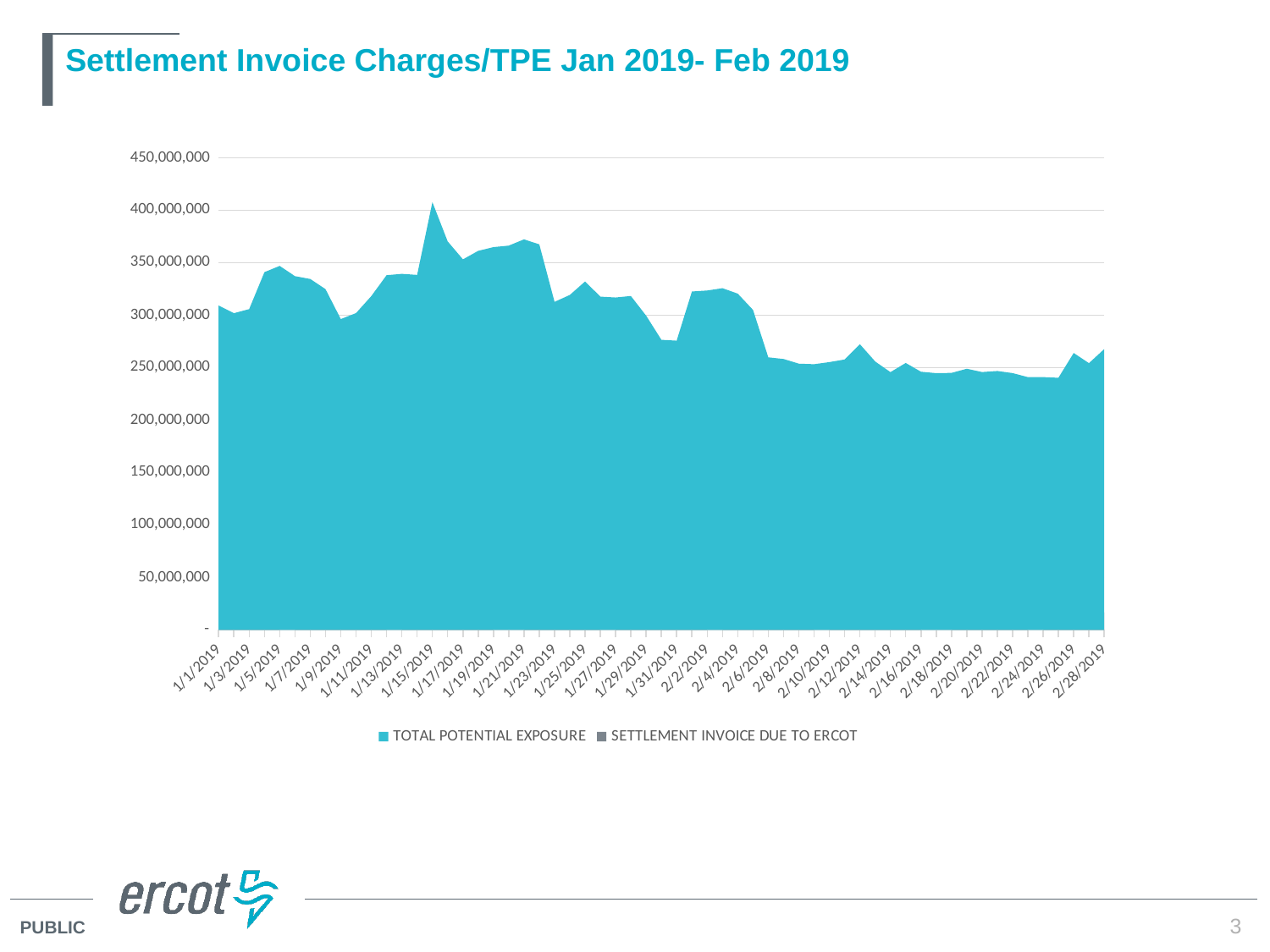
On which date does Total Potential Exposure reach its highest value? 1/15/2019 Overall, does Total Potential Exposure rise or fall from January 2019 to February 2019? fall What kind of chart is shown on the slide? Area chart What are the two series named in the legend? TOTAL POTENTIAL EXPOSURE and SETTLEMENT INVOICE DUE TO ERCOT Is the Total Potential Exposure on 1/15/2019 greater or less than 350,000,000? greater Which date has the larger Total Potential Exposure, 1/5/2019 or 2/14/2019? 1/5/2019 How many series does the legend list? 2 Is the Total Potential Exposure on 1/21/2019 greater or less than 350,000,000? greater Is the Total Potential Exposure on 2/8/2019 greater or less than 300,000,000? less How many date labels are shown on the x axis? 30 What is the title of the slide's chart? Settlement Invoice Charges/TPE Jan 2019- Feb 2019